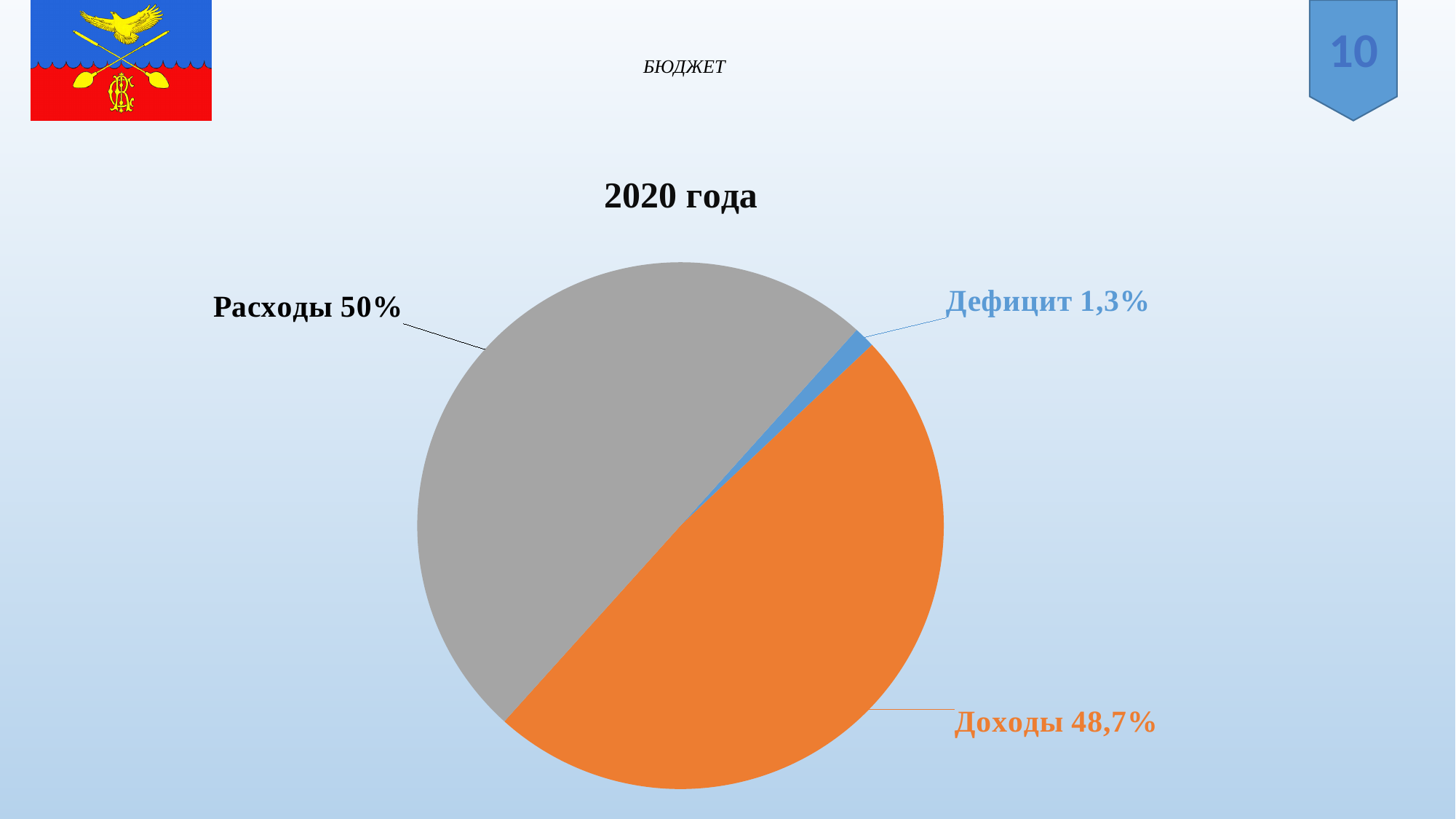
What share of the pie is labelled Доходы? 48,7% What type of chart is shown on the slide? pie chart Which is larger, Расходы or Доходы? Расходы What share of the pie is labelled Дефицит? 1,3% What colour is the Доходы slice? orange What is the difference between the Доходы and Дефицит shares? 47,4% Which slice of the pie is the largest? Расходы What share of the pie is labelled Расходы? 50% What is the difference between the Расходы and Доходы shares? 1,3% What is the title of the chart? 2020 года Which slice of the pie is the smallest? Дефицит How many slices does the pie chart have? 3